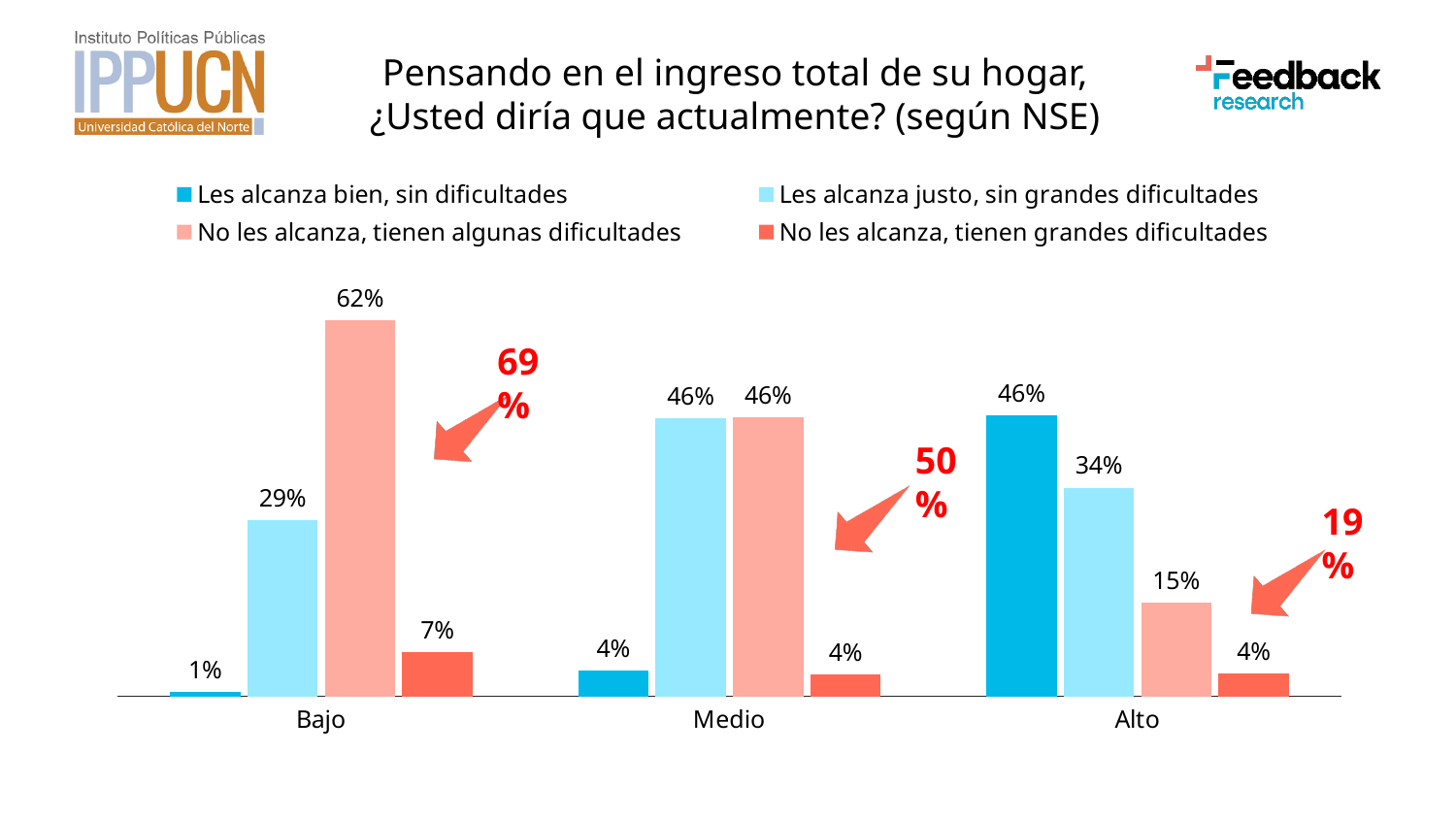
What is the difference between the "Les alcanza justo, sin grandes dificultades" values for Alto and Bajo? 5% Which is larger: "Les alcanza justo, sin grandes dificultades" for Bajo or "No les alcanza, tienen algunas dificultades" for Alto? Les alcanza justo, sin grandes dificultades for Bajo In which NSE group is the value for "No les alcanza, tienen algunas dificultades" lowest? Alto What is the value for "Les alcanza bien, sin dificultades" in the Alto group? 46% What is the value for "Les alcanza justo, sin grandes dificultades" in the Medio group? 46% How many series does the legend list? 4 What is the value for "No les alcanza, tienen algunas dificultades" in the Bajo group? 62% How many NSE categories are shown on the x axis? 3 What red annotated percentage is shown next to the Medio group? 50% What kind of chart is shown on the slide? bar chart What is the value for "No les alcanza, tienen grandes dificultades" in the Bajo group? 7% In which NSE group is the value for "Les alcanza bien, sin dificultades" highest? Alto